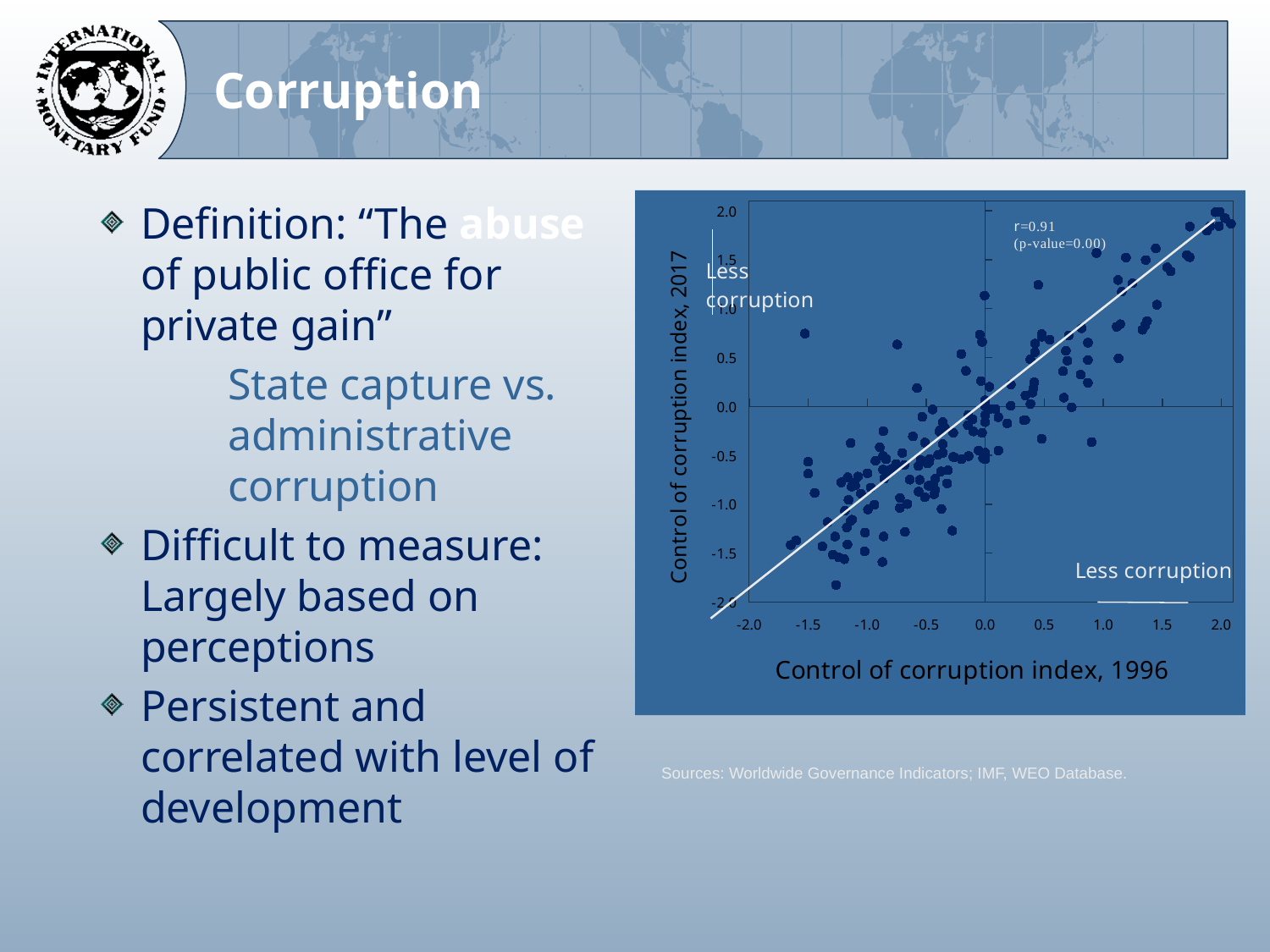
What p-value is printed on the chart? 0.00 What is the highest tick value shown on the x axis? 2.0 What is the label of the y axis of the chart? Control of corruption index, 2017 What correlation coefficient (r) is printed on the chart? r=0.91 As the control of corruption index for 1996 increases along the x axis, does the 2017 index generally rise or fall? Rise What kind of chart is shown on the slide? Scatter plot What is the lowest tick value shown on the y axis? -2.0 What is the label of the x axis of the chart? Control of corruption index, 1996